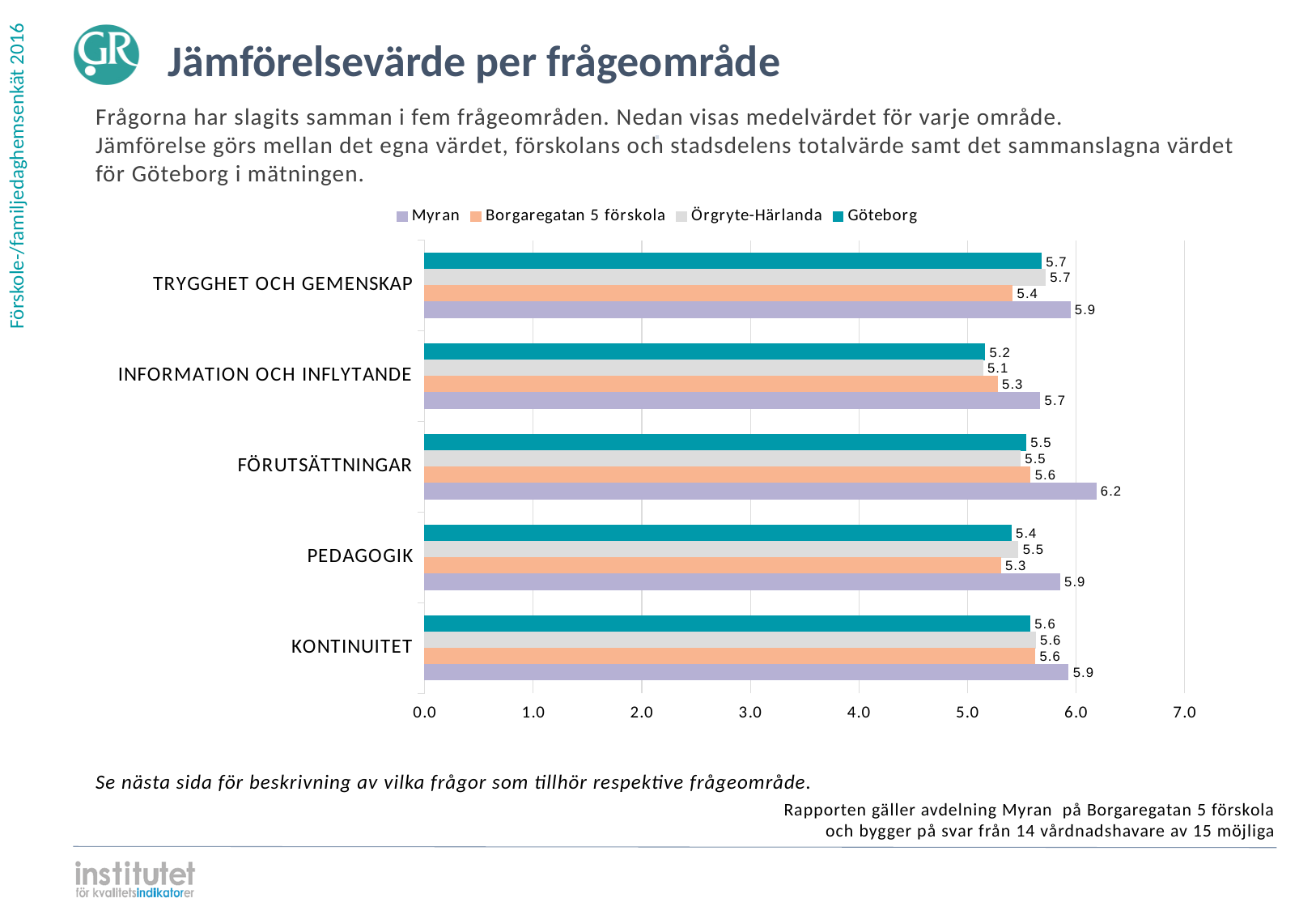
Is the value for Myran in the FÖRUTSÄTTNINGAR category greater or less than 6.0? greater What is the value for Borgaregatan 5 förskola in the TRYGGHET OCH GEMENSKAP category? 5.4 In which category does Göteborg have its lowest value? INFORMATION OCH INFLYTANDE How many question areas (categories) are shown on the chart? 5 How many series does the legend list? 4 In the PEDAGOGIK category, which is larger: the value for Myran or the value for Göteborg? Myran What is the value for Örgryte-Härlanda in the PEDAGOGIK category? 5.5 In which category does Myran have its highest value? FÖRUTSÄTTNINGAR What is the difference between the Myran value and the Borgaregatan 5 förskola value in the INFORMATION OCH INFLYTANDE category? 0.4 What is the value for Myran in the FÖRUTSÄTTNINGAR category? 6.2 What kind of chart is shown on the slide? Bar chart What is the value for Göteborg in the INFORMATION OCH INFLYTANDE category? 5.2